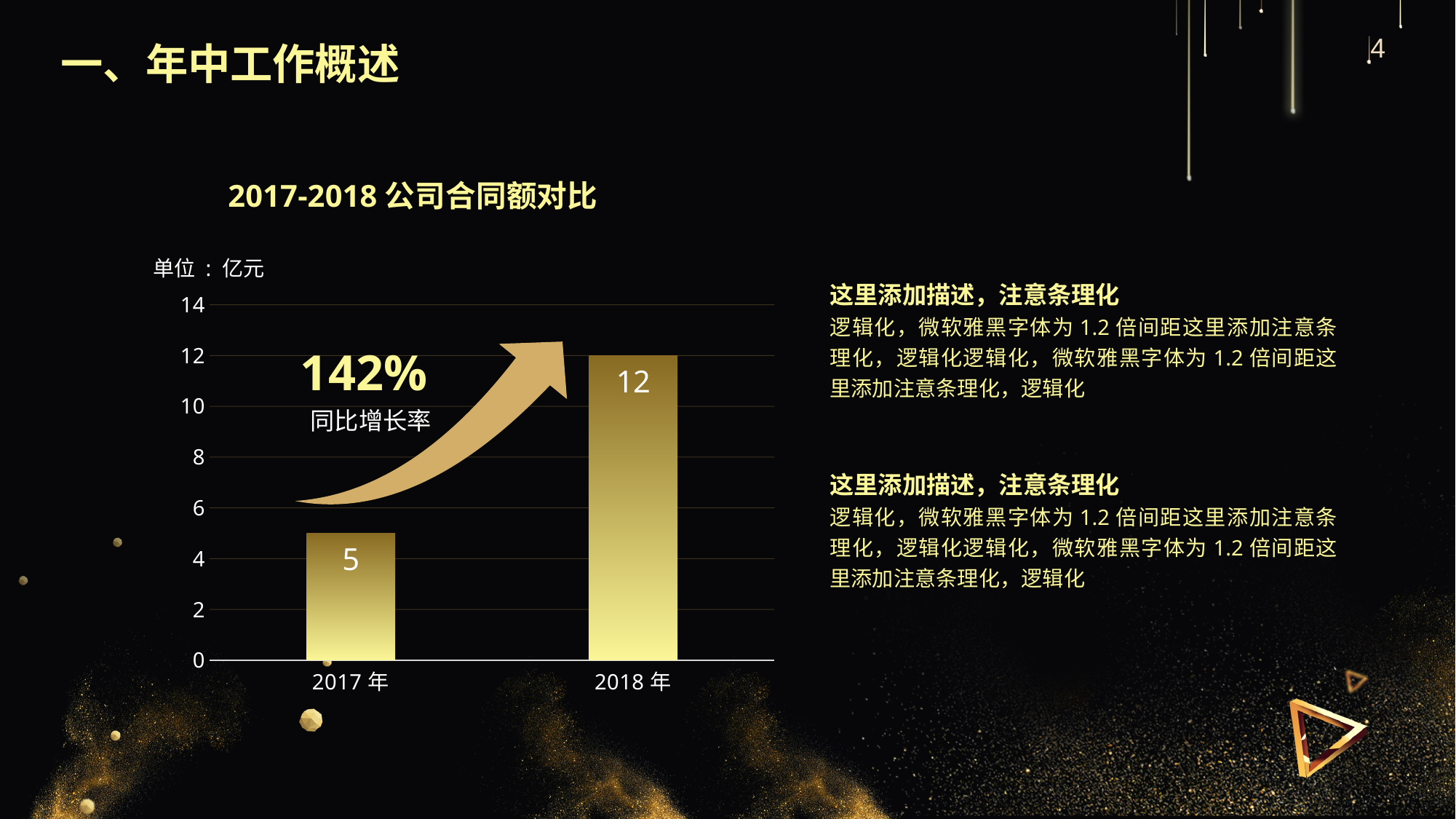
Is the value for 2018 年 greater or less than 10? greater What kind of chart is shown on the slide? bar chart Which year has the lower contract amount? 2017 年 Is the value for 2018 年 larger or smaller than the value for 2017 年? larger Do the values rise or fall from 2017 年 to 2018 年? rise Is the value for 2017 年 greater or less than 6? less How many categories are shown on the x axis? 2 What is the difference between the values for 2018 年 and 2017 年? 7 What is the title of the chart? 2017-2018 公司合同额对比 What is the value for 2017 年? 5 What is the value for 2018 年? 12 Which year has the higher contract amount? 2018 年